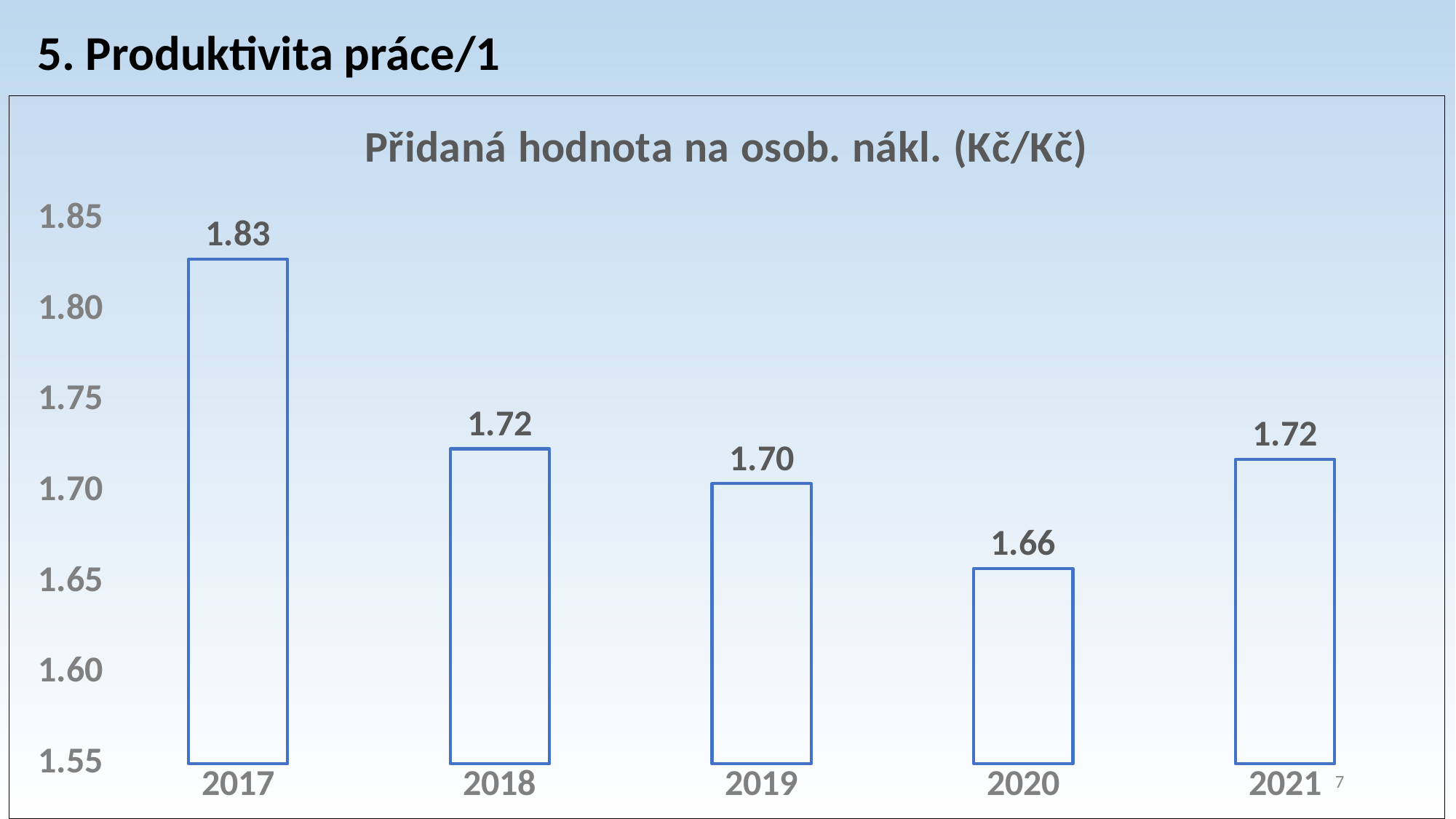
How many years are shown on the chart? 5 What is the difference between the values for 2017 and 2020? 0.17 What is the title of the chart? Přidaná hodnota na osob. nákl. (Kč/Kč) What is the value for 2020? 1.66 Which is larger, the value for 2018 or the value for 2019? 2018 Is the value for 2020 greater or less than 1.70? less What is the value for 2019? 1.70 Which year has the highest value? 2017 What is the value for 2017? 1.83 What is the difference between the values for 2021 and 2020? 0.06 What kind of chart is shown? bar chart Which year has the lowest value? 2020